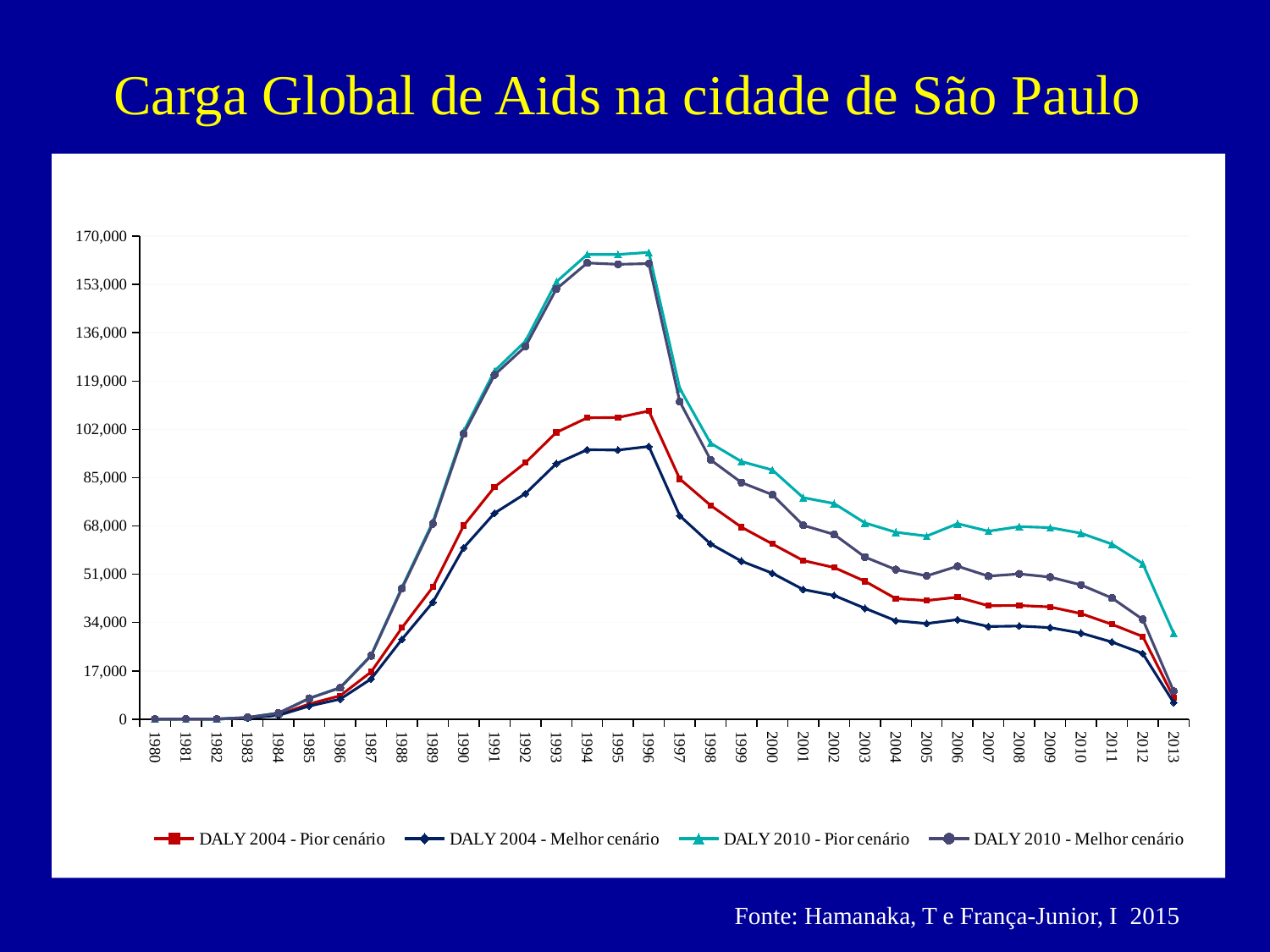
In which year is the value of 'DALY 2004 - Melhor cenário' lowest? 1980 Is the value for 'DALY 2010 - Pior cenário' in 1996 greater or less than 153,000? greater Does the series 'DALY 2010 - Pior cenário' rise or fall from 1996 to 2013? Fall Is the value for 'DALY 2004 - Melhor cenário' in 1996 greater or less than 102,000? less In which year does the series 'DALY 2010 - Pior cenário' reach its highest value? 1996 In 1996, which series has the larger value: 'DALY 2010 - Pior cenário' or 'DALY 2004 - Pior cenário'? DALY 2010 - Pior cenário How many years are plotted along the x axis? 34 Which colour is used for the series 'DALY 2004 - Pior cenário'? Red Is the value for 'DALY 2004 - Pior cenário' in 2000 greater or less than 51,000? greater What is the title of the chart? Carga Global de Aids na cidade de São Paulo How many series does the legend list? 4 What kind of chart is shown on the slide? Line chart